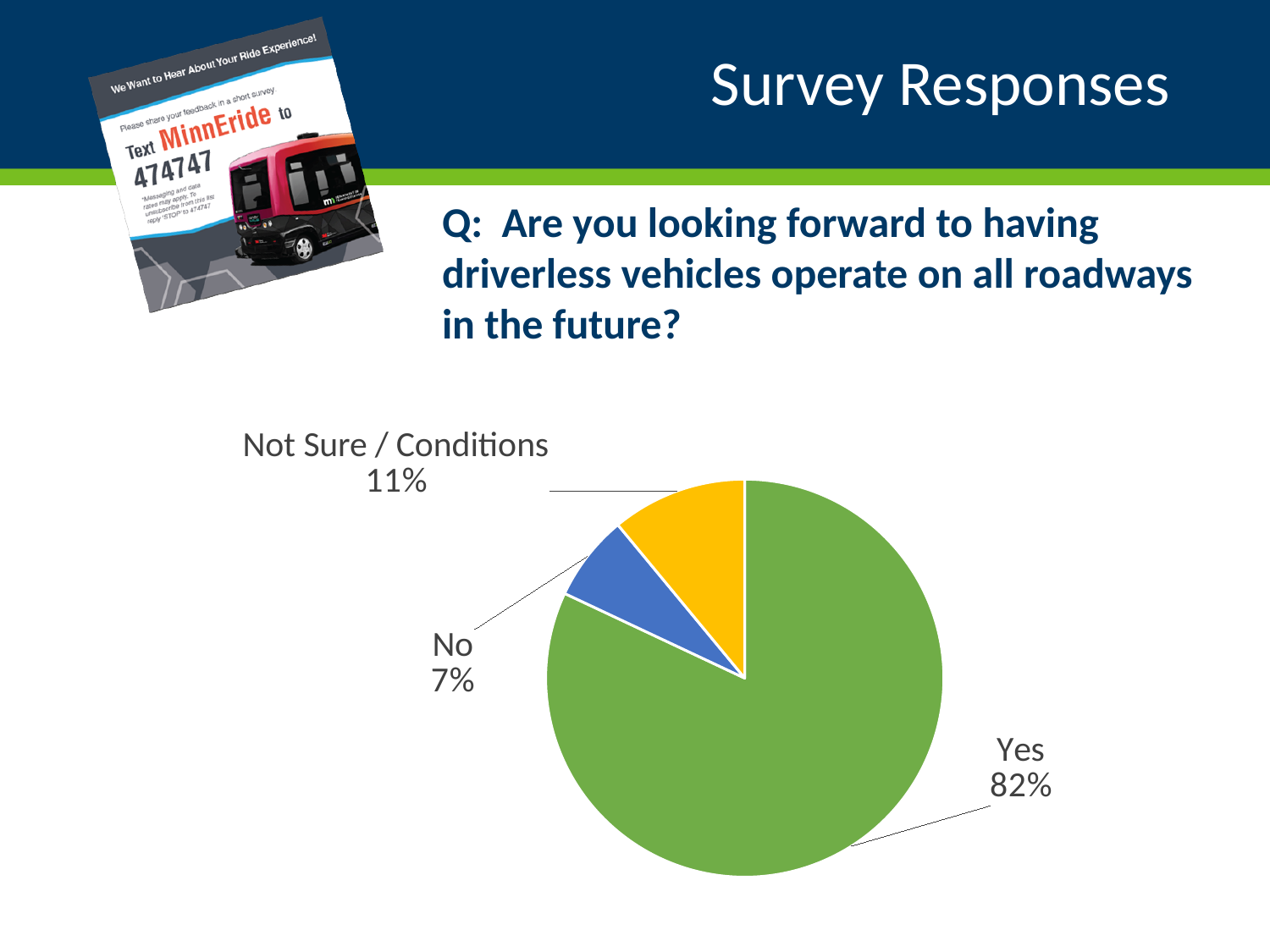
What share of responses is "Not Sure / Conditions"? 11% Which response category has the largest share of the pie? Yes What is the difference in percentage points between the "Not Sure / Conditions" and "No" shares? 4 What kind of chart is shown on the slide? pie chart What share of responses is "No"? 7% What survey question does the pie chart show responses to? Are you looking forward to having driverless vehicles operate on all roadways in the future? Which response category has the smallest share of the pie? No How many slices does the pie chart have? 3 What is the difference in percentage points between the "Yes" and "No" shares? 75 Which is larger, the share for "Not Sure / Conditions" or the share for "No"? Not Sure / Conditions What colour is the "Yes" slice of the pie chart? green What share of responses is "Yes"? 82%